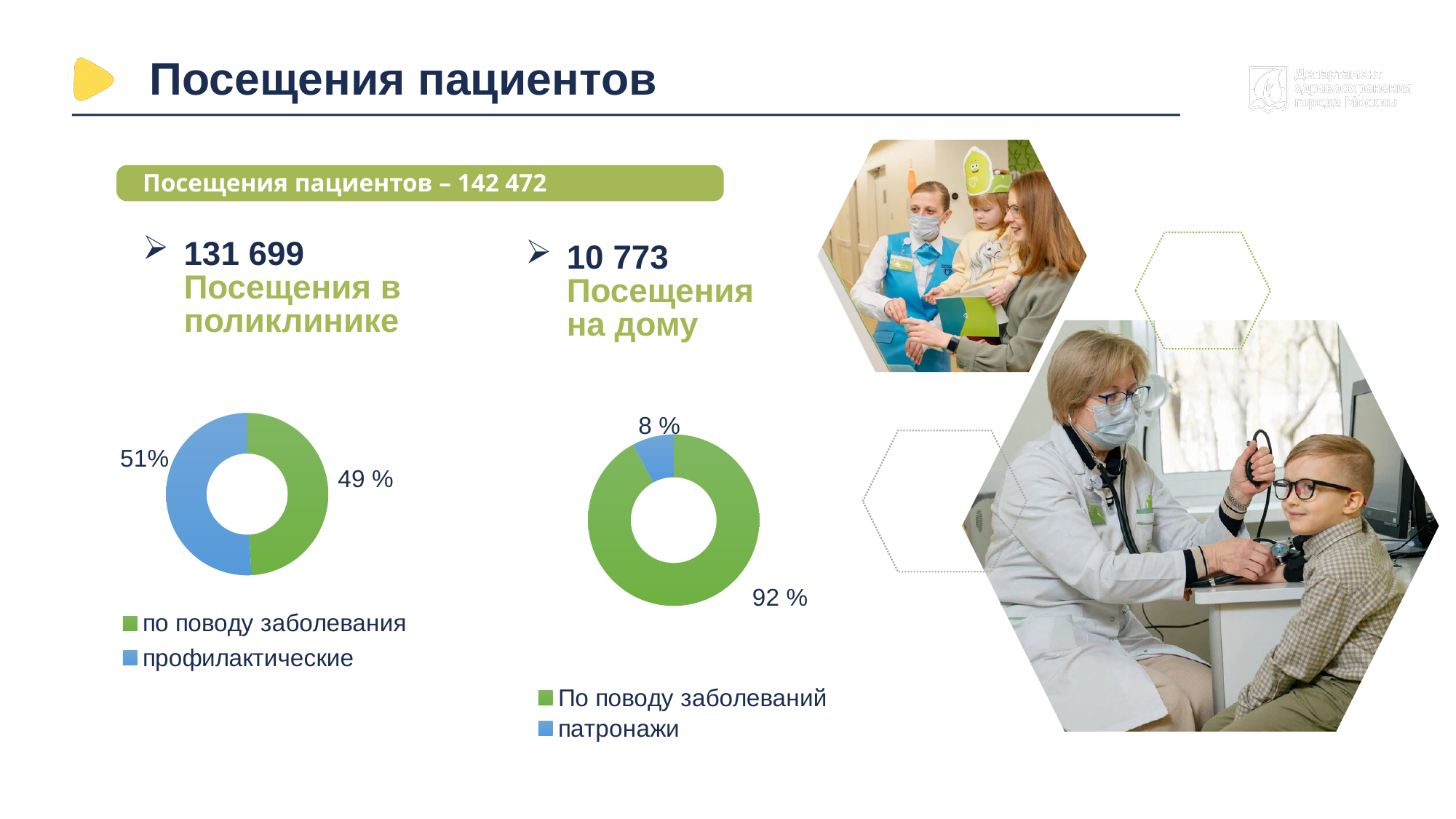
How many categories does the legend of the right donut chart (Посещения на дому) list? 2 In the right donut chart (Посещения на дому), what share is labelled for патронажи? 8 % In the left donut chart (Посещения в поликлинике), what share is labelled for профилактические? 51% In the left donut chart (Посещения в поликлинике), which is larger: по поводу заболевания or профилактические? профилактические In the right donut chart (Посещения на дому), which category has the largest share? По поводу заболеваний In the right donut chart (Посещения на дому), what is the difference in percentage points between По поводу заболеваний and патронажи? 84 In the left donut chart (Посещения в поликлинике), what colour represents профилактические? Blue In the right donut chart (Посещения на дому), which category has the smallest share? патронажи In the left donut chart (Посещения в поликлинике), what share is labelled for по поводу заболевания? 49 % In the right donut chart (Посещения на дому), what share is labelled for По поводу заболеваний? 92 % In the right donut chart (Посещения на дому), what colour represents По поводу заболеваний? Green What type of chart is used on the left (Посещения в поликлинике)? Donut (pie) chart